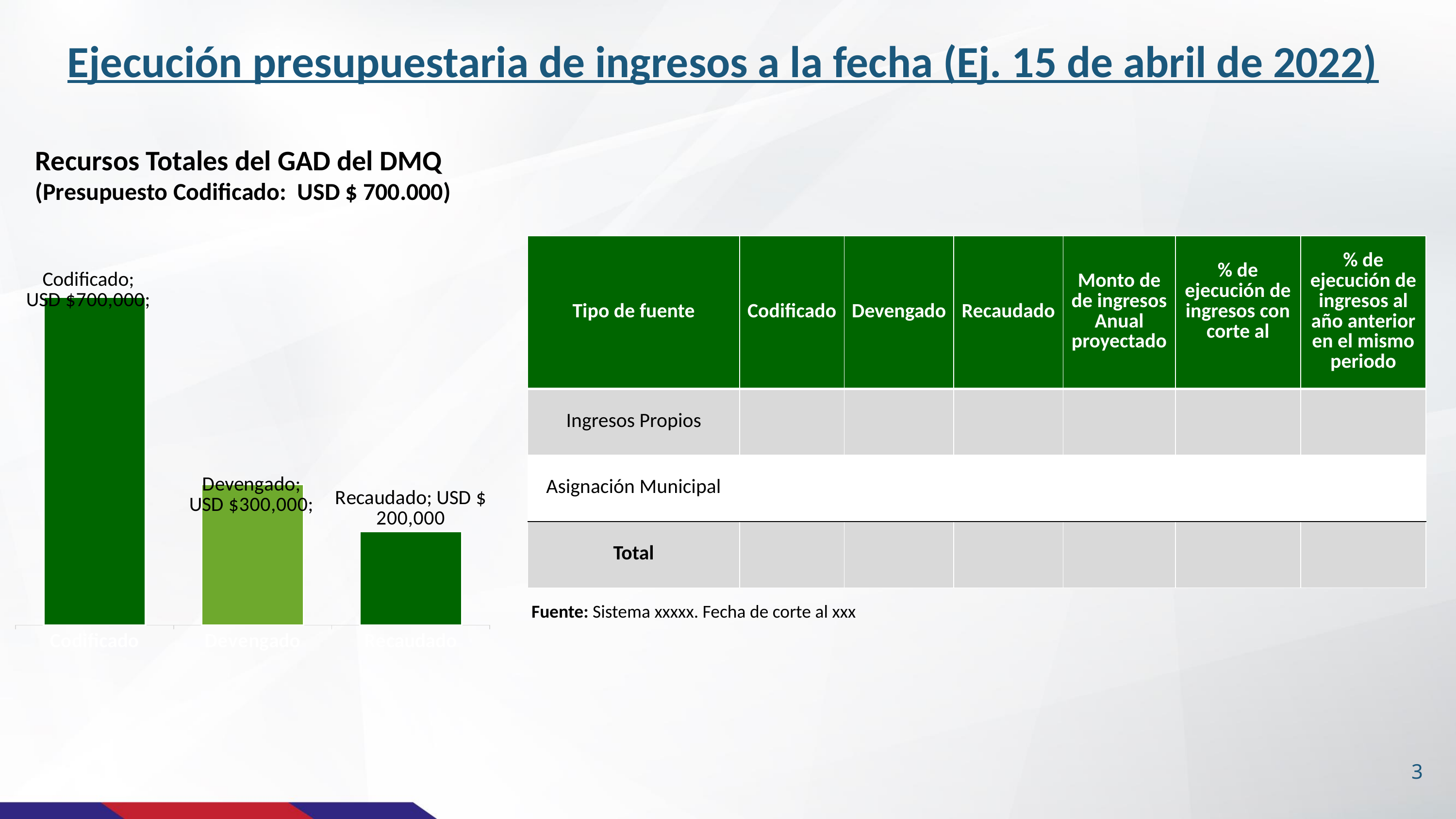
What is the value for Recaudado in the bar chart? USD $ 200,000 What is the difference between the Codificado and Devengado values? USD $400,000 Which is larger, the value for Devengado or the value for Recaudado? Devengado Which category has the highest value in the bar chart? Codificado What is the title of the chart on the slide? Recursos Totales del GAD del DMQ What is the difference between the Devengado and Recaudado values? USD $100,000 Which category has the lowest value in the bar chart? Recaudado How many bars are shown in the chart? 3 Do the values rise or fall from left to right across the bars? Fall What is the value for Codificado in the bar chart? USD $700,000 What is the value for Devengado in the bar chart? USD $300,000 What kind of chart is shown on the slide? Bar chart